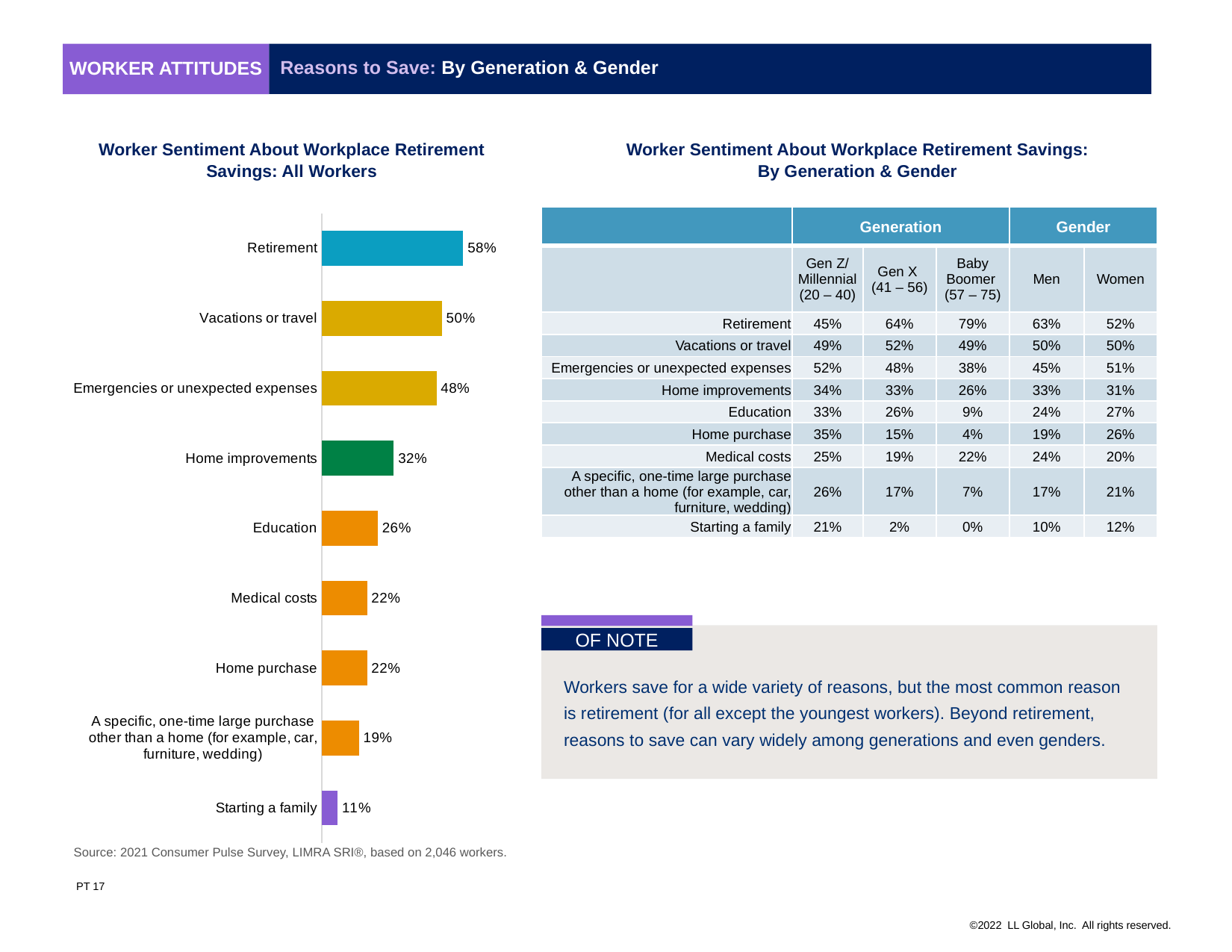
What type of chart is shown on the left of the slide? Bar chart In the bar chart, what is the value for Home improvements? 32% In the bar chart, what is the value for Education? 26% In the bar chart, what percentage of all workers cite retirement as a reason to save? 58% How many categories are shown in the bar chart? 9 Which category has the lowest value in the bar chart? Starting a family In the bar chart, what is the difference between the values for Retirement and Vacations or travel? 8% In the bar chart, what is the value for Starting a family? 11% In the bar chart, which is larger: Vacations or travel or Emergencies or unexpected expenses? Vacations or travel What is the title of the bar chart on the slide? Worker Sentiment About Workplace Retirement Savings: All Workers Which category has the highest value in the bar chart? Retirement In the bar chart, what is the difference between Home improvements and Starting a family? 21%